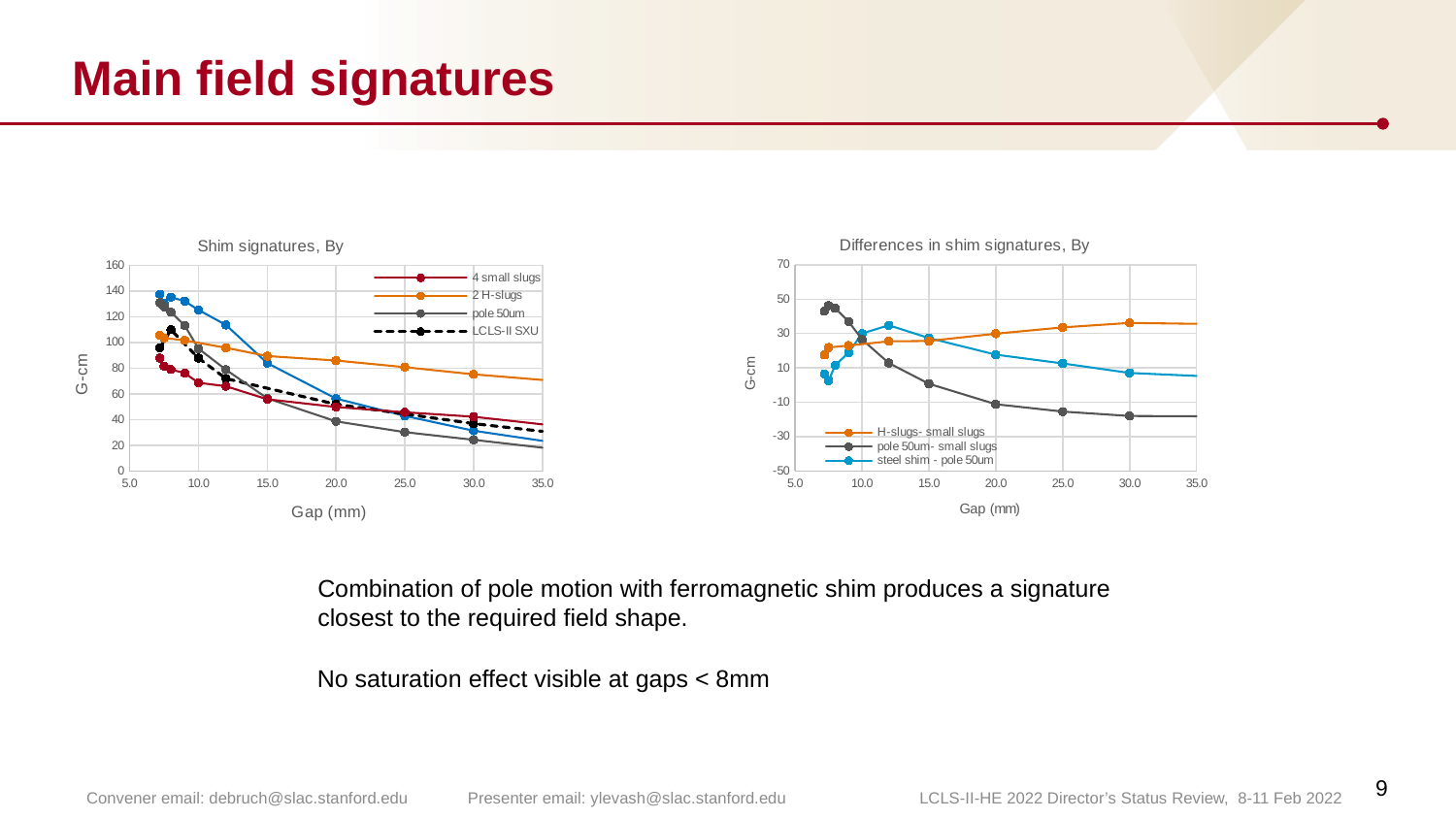
In the 'Differences in shim signatures, By' chart, at a gap of 30.0 mm, which is larger: 'H-slugs- small slugs' or 'pole 50um- small slugs'? H-slugs- small slugs In the 'Shim signatures, By' chart, which series has the highest value at a gap of 35.0 mm? 2 H-slugs In the 'Differences in shim signatures, By' chart, is the value of the 'pole 50um- small slugs' series at a gap of 30.0 mm greater or less than -10? less How many series does the legend of the 'Differences in shim signatures, By' chart list? 3 What is the x-axis label of the 'Shim signatures, By' chart? Gap (mm) In the 'Shim signatures, By' chart, does the '2 H-slugs' series rise or fall as the gap increases? fall How many series does the legend of the 'Shim signatures, By' chart list? 4 In the 'Shim signatures, By' chart, is the value of the 'pole 50um' series at a gap of 35.0 mm greater or less than 40? less In the 'Shim signatures, By' chart, is the value of the '2 H-slugs' series at a gap of 35.0 mm greater or less than 60? greater In the 'Differences in shim signatures, By' chart, does the 'pole 50um- small slugs' series rise or fall as the gap increases? fall What type of chart is the 'Shim signatures, By' chart on the left? line chart